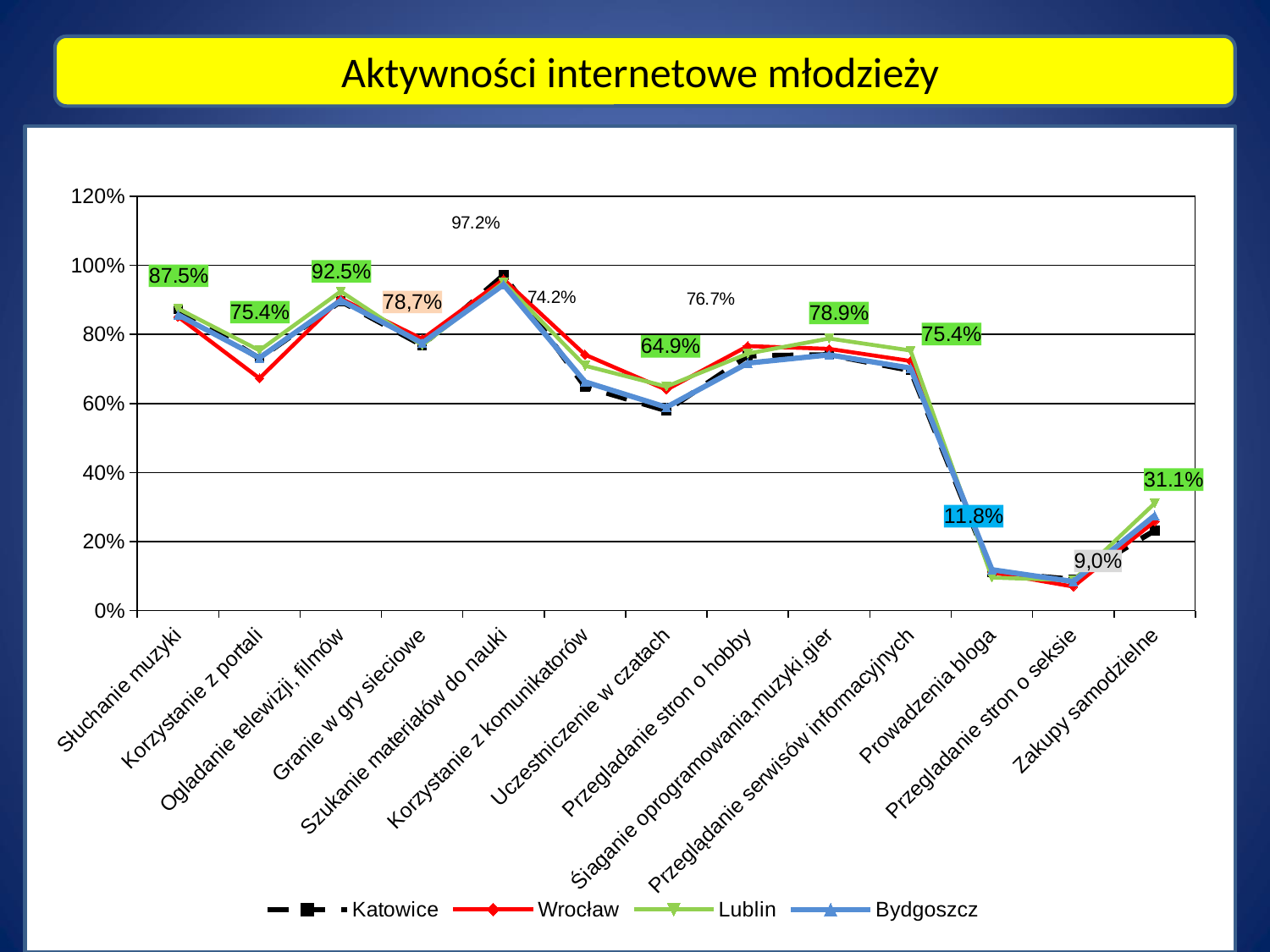
What kind of chart is shown on the slide? line chart Which category has the lowest values across all series? Przeglądanie stron o seksie Which series are listed in the legend? Katowice, Wrocław, Lublin, Bydgoszcz Is the value for Prowadzenia bloga for Lublin greater or less than 20%? less What value is labeled at the category Zakupy samodzielne? 31.1% For Bydgoszcz, which is larger: the value for Słuchanie muzyki or the value for Prowadzenia bloga? Słuchanie muzyki How many series does the legend list? 4 What value is labeled at the category Szukanie materiałów do nauki? 97.2% Is the value for Słuchanie muzyki for Katowice greater or less than 80%? greater What is the title of the slide? Aktywności internetowe młodzieży Which category has the highest values across all series? Szukanie materiałów do nauki How many categories are shown on the x axis? 13